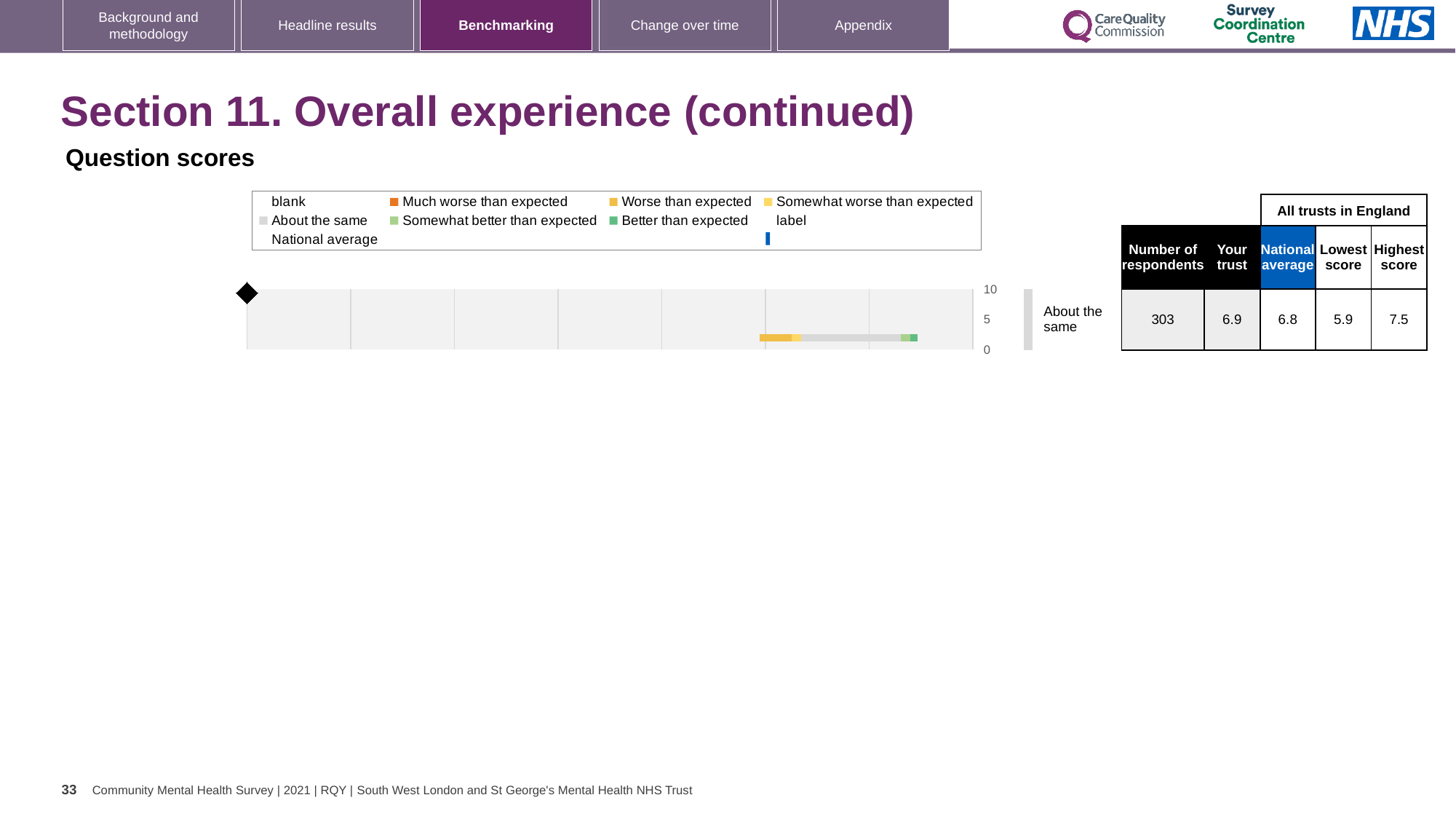
In the table next to the chart, what is the Lowest score among all trusts in England? 5.9 What is the label of the single category plotted in the question scores chart? About the same What kind of chart is shown under 'Question scores'? bar chart Which is larger in the table next to the chart: the 'Your trust' score or the National average? Your trust How many categories (rows) are plotted in the question scores chart? 1 In the table next to the chart, how many respondents are listed? 303 In the table next to the chart, what is the Highest score among all trusts in England? 7.5 What is the difference between the Highest score and the Lowest score in the table next to the chart? 1.6 In the table next to the chart, what is the National average score? 6.8 In the table next to the chart, what is the 'Your trust' score for the question rated 'About the same'? 6.9 What is the highest value shown on the axis of the question scores chart? 10 What is the difference between the 'Your trust' score and the National average in the table next to the chart? 0.1